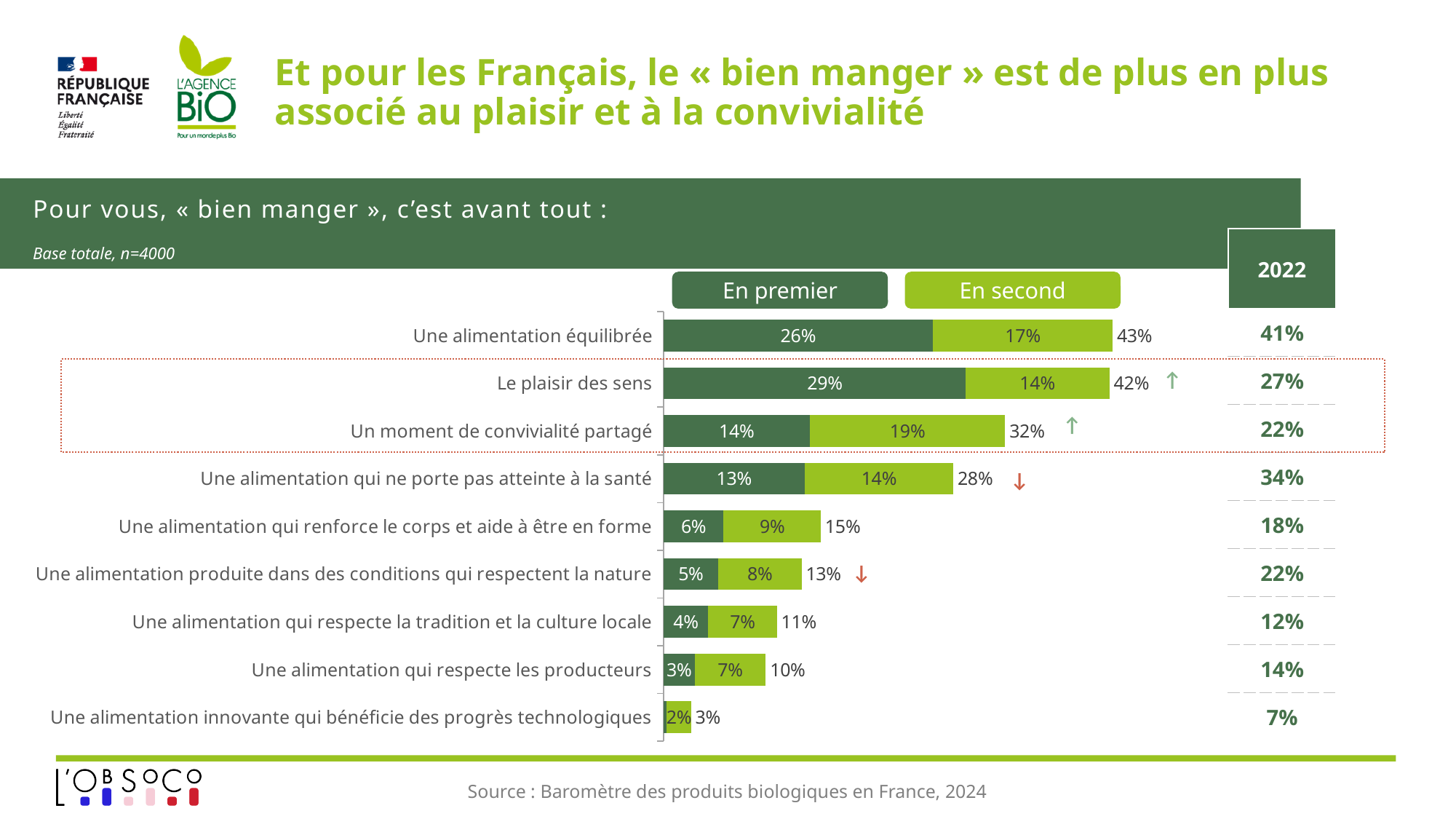
What are the two legend entries of the chart? En premier and En second What kind of chart is shown on the slide? Stacked bar chart What is the "En second" value for "Un moment de convivialité partagé"? 19% Which category has the lowest total value? Une alimentation innovante qui bénéficie des progrès technologiques Which has the larger "En second" value: "Un moment de convivialité partagé" or "Une alimentation équilibrée"? Un moment de convivialité partagé What is the "En premier" value for "Le plaisir des sens"? 29% How many categories are shown in the chart? 9 How many series does the legend list? 2 For "Une alimentation équilibrée", how much larger is the "En premier" value than the "En second" value? 9 percentage points Which category has the highest "En premier" value? Le plaisir des sens What is the total (En premier + En second) shown for "Une alimentation équilibrée"? 43% What is the 2022 value shown for "Le plaisir des sens"? 27%